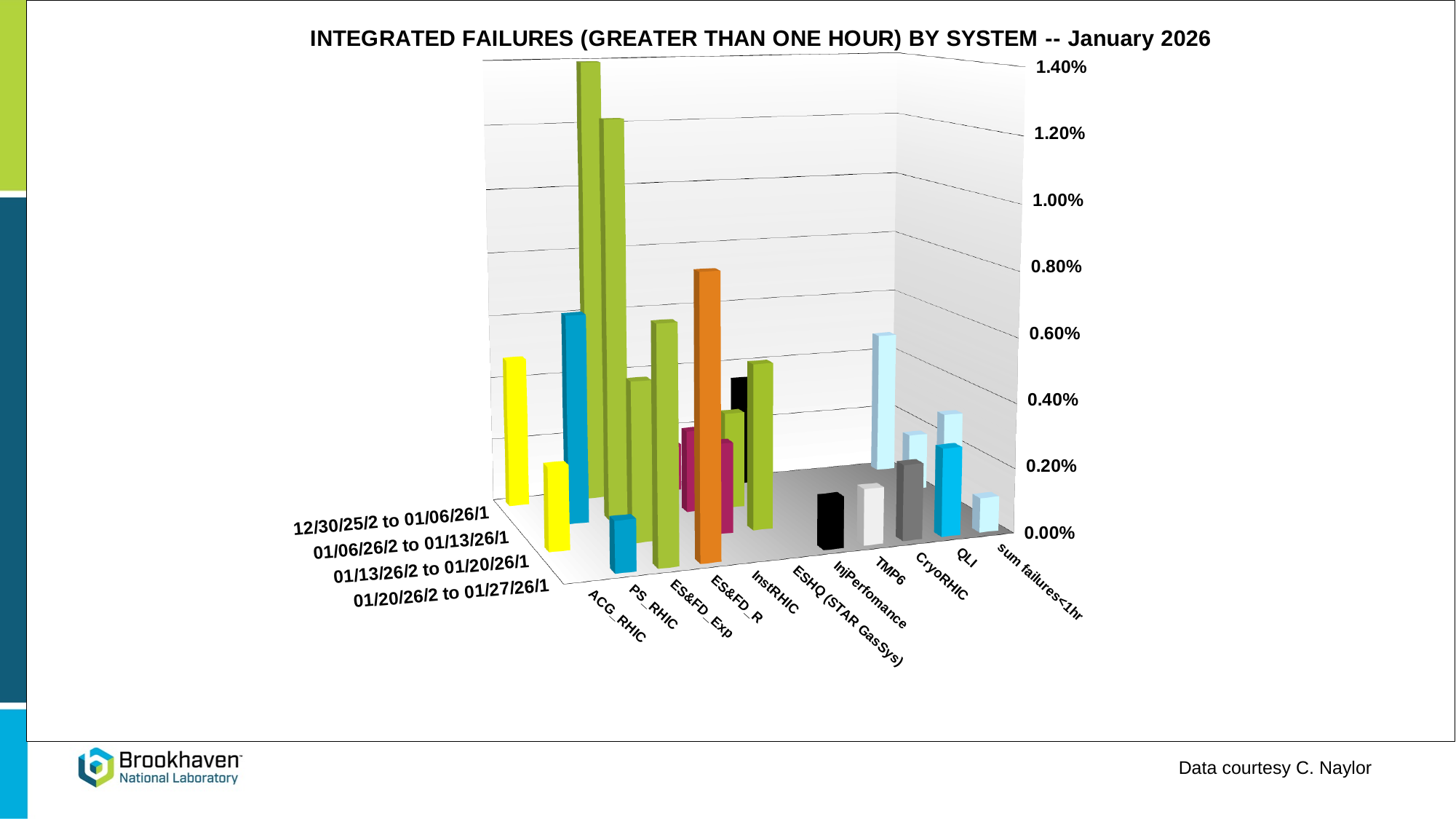
Is the tallest bar for InjPerfomance greater or less than 0.40%? less How many system categories are shown along the horizontal axis of the chart? 11 What kind of chart is shown on the slide? bar chart Which is the last category listed on the horizontal axis of the chart? sum failures<1hr Is the tallest bar for ES&FD_Exp greater or less than 1.00%? greater How many weekly date ranges are plotted in the chart? 4 Which is the first date range listed on the depth axis of the chart? 12/30/25/2 to 01/06/26/1 Which system has the tallest bar in the chart? ES&FD_Exp What is the title of the chart? INTEGRATED FAILURES (GREATER THAN ONE HOUR) BY SYSTEM -- January 2026 What is the highest value shown on the vertical axis of the chart? 1.40%